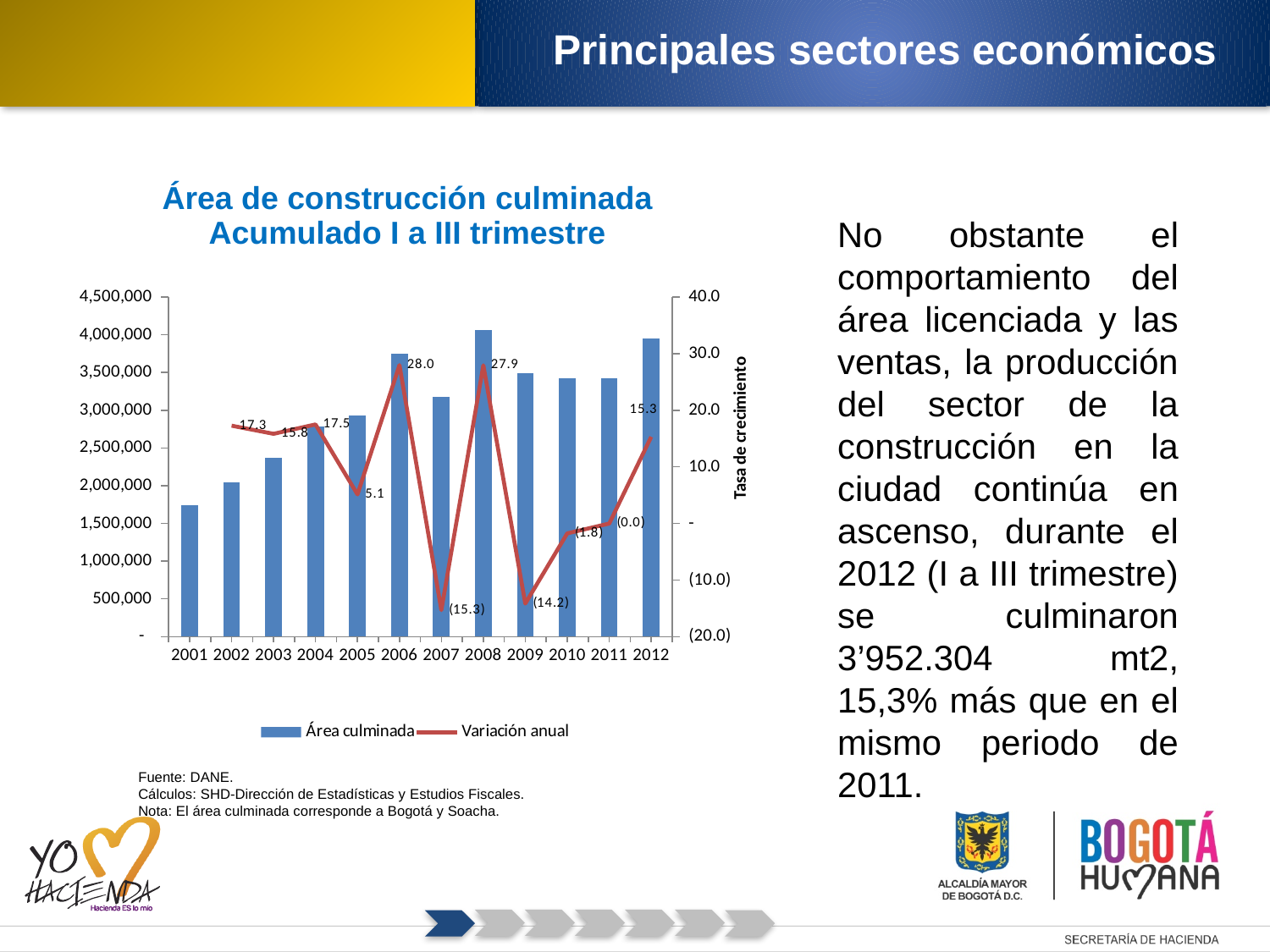
In which year is the Variación anual line at its lowest value? 2007 Is the Área culminada bar for 2003 greater or less than 2,500,000? less How many series does the chart legend list? 2 What is the Variación anual value shown for 2007? (15.3) Do the Área culminada bars rise or fall from 2001 to 2006? rise How many years are shown on the x axis of the chart? 12 What is the Variación anual value for 2012? 15.3 In which year is the Variación anual line at its highest value? 2006 Which year has a taller Área culminada bar, 2006 or 2007? 2006 What is the Variación anual value shown for 2005? 5.1 What is the Variación anual value for 2006? 28.0 Is the Área culminada bar for 2008 greater or less than 4,000,000? greater